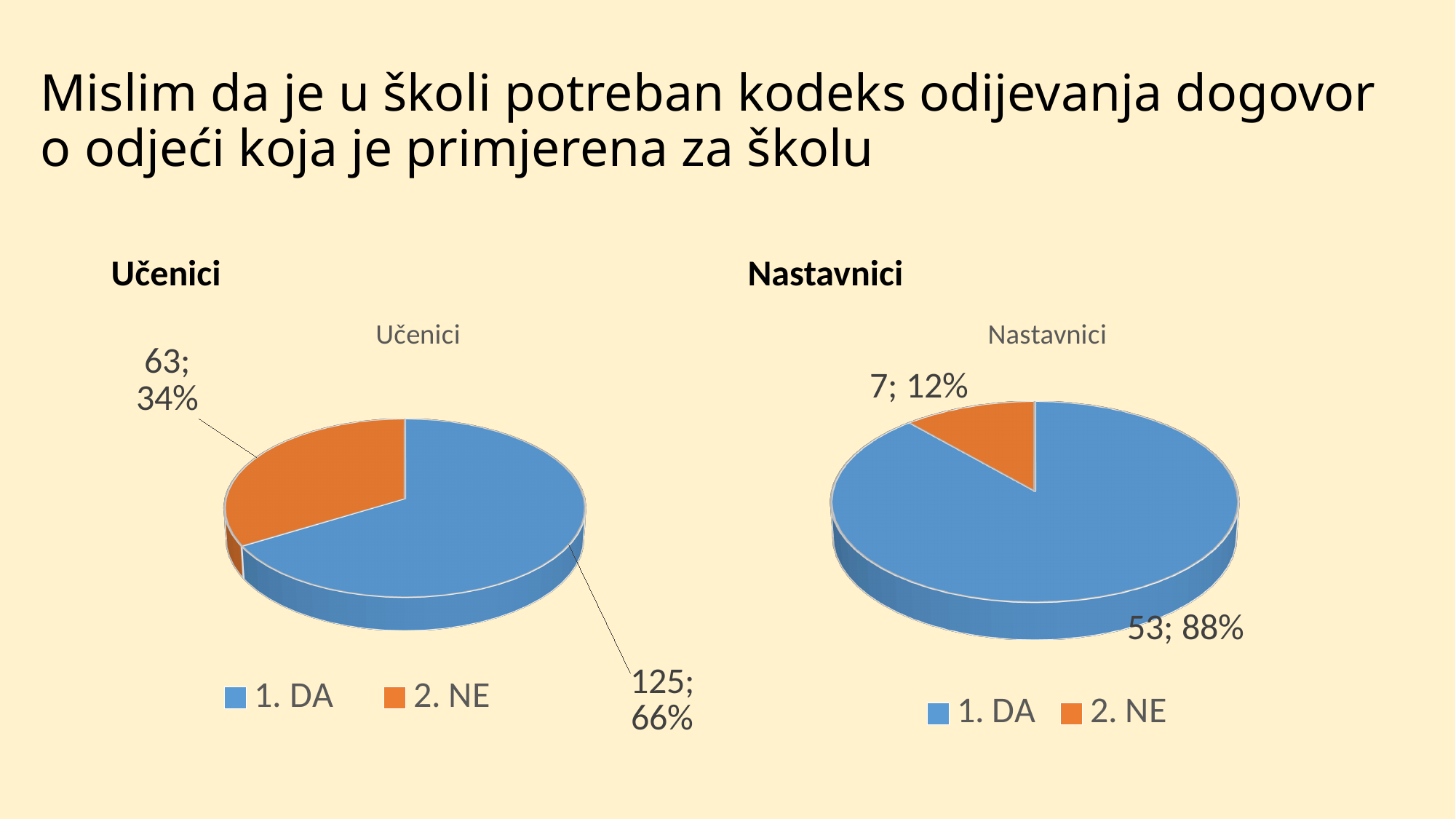
In the Nastavnici chart, which answer has the smallest slice? 2. NE In the Nastavnici chart, what colour is the 2. NE slice? Orange In the Nastavnici chart, how many respondents answered 2. NE? 7 In the Učenici chart, which answer has the largest slice? 1. DA In the Učenici chart, what is the difference between the number of 1. DA and 2. NE responses? 62 In the Nastavnici chart, what is the total number of responses across both slices? 60 How many slices does the Učenici pie chart have? 2 In the Nastavnici chart, what share of the pie is 1. DA? 88% What kind of chart is the Nastavnici chart? Pie chart In the Učenici chart, what share of the pie is 2. NE? 34% In the Učenici chart, how many respondents answered 1. DA? 125 In the Učenici chart, is the count for 1. DA or 2. NE larger? 1. DA